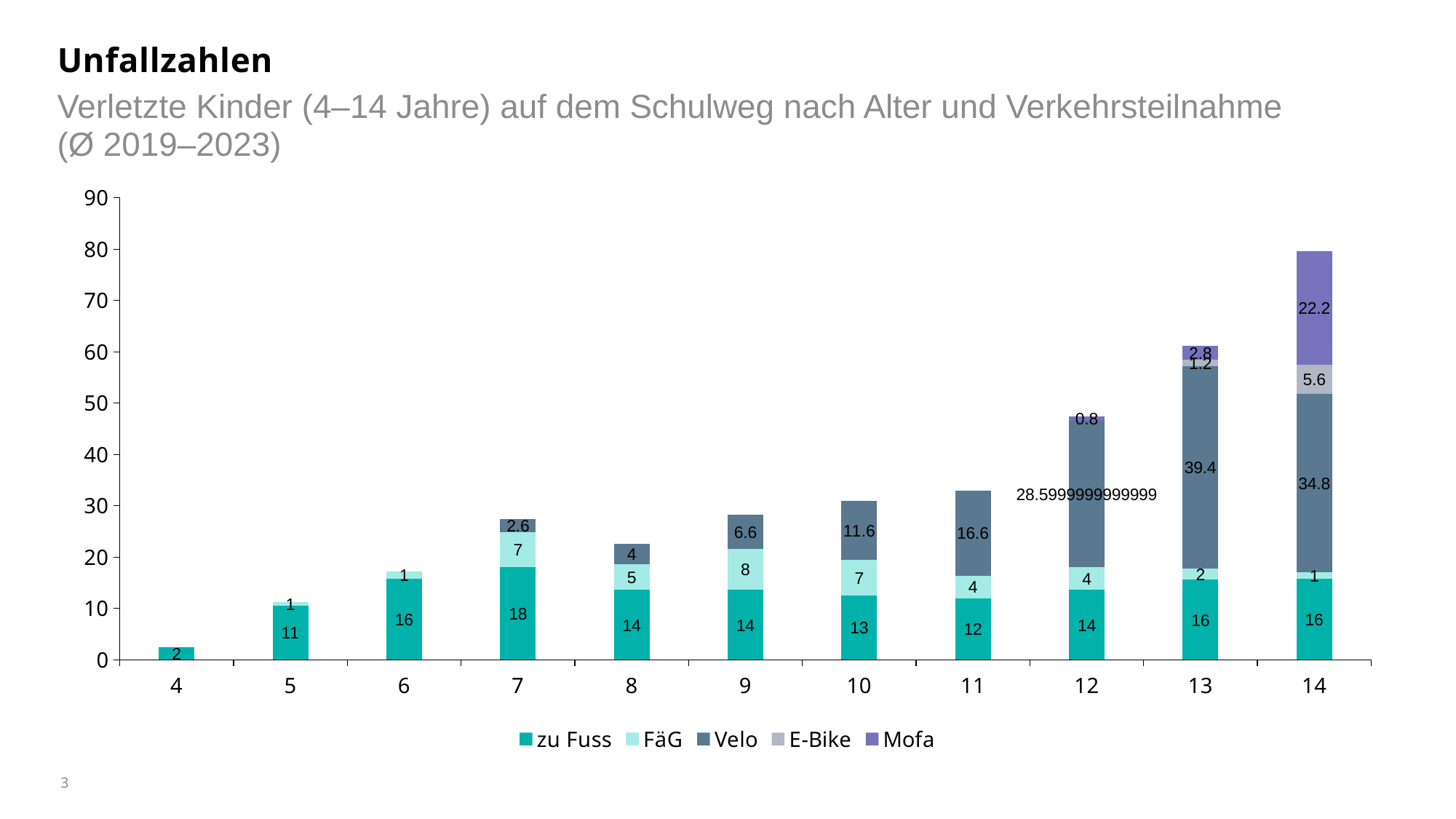
How many series does the legend list? 5 Which is larger: the 'E-Bike' value at age 14 or at age 13? Age 14 What type of chart is shown on the slide? Stacked bar chart At which age is the 'zu Fuss' value lowest? 4 What is the value for 'Velo' at age 13? 39.4 What is the total of the stacked bar for age 14? 79.6 What is the value for 'Mofa' at age 14? 22.2 How many age categories are shown on the x axis? 11 What is the value for 'zu Fuss' at age 7? 18 What is the difference between the 'Velo' values at age 13 and age 14? 4.6 What is the value for 'FäG' at age 9? 8 At which age is the 'zu Fuss' value highest? 7